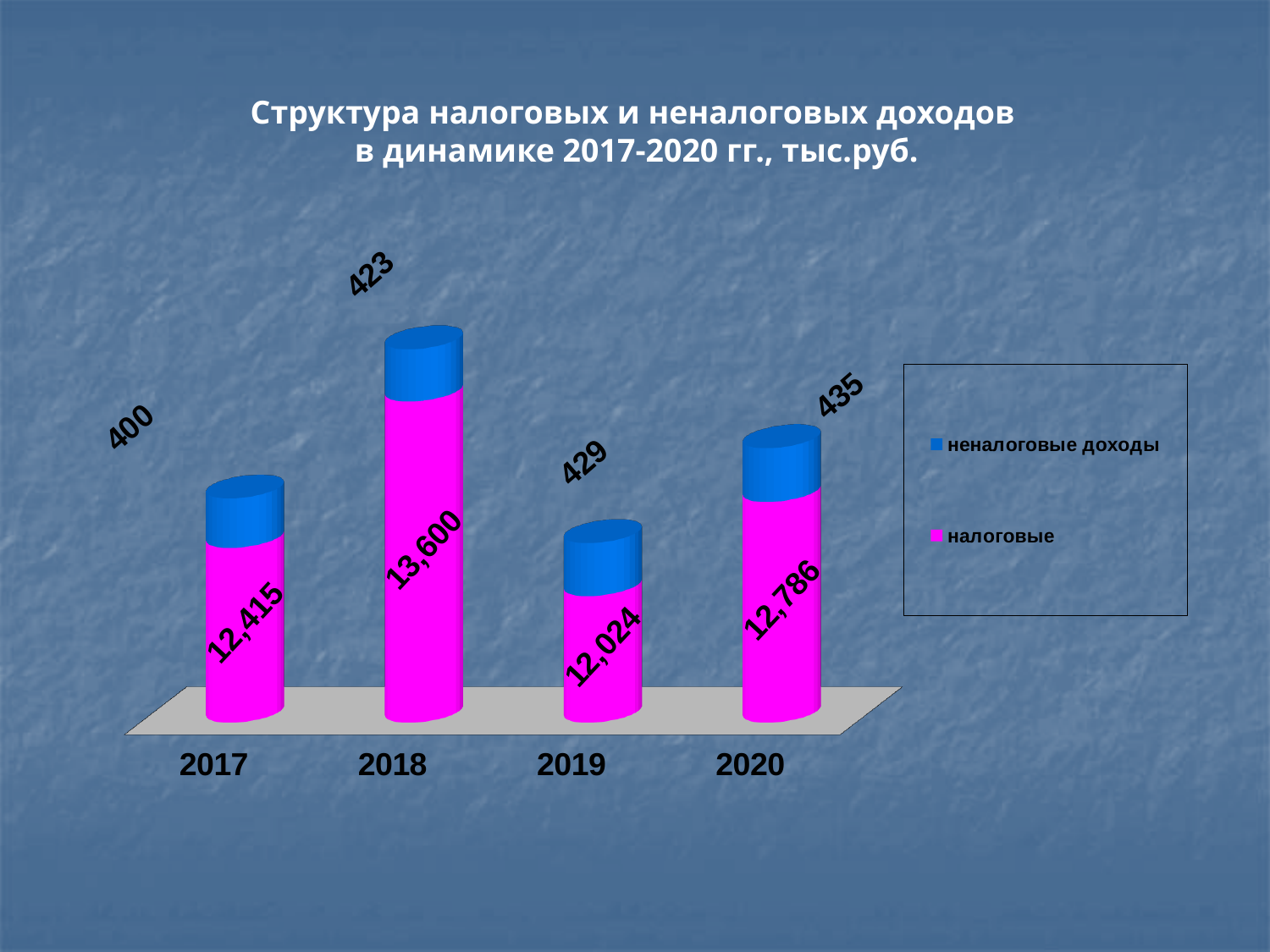
Which is larger, the налоговые value for 2017 or for 2020? 2020 What is the value of налоговые for 2019? 12,024 What is the value of неналоговые доходы for 2020? 435 How many series does the legend list? 2 How many years are shown on the x axis? 4 What kind of chart is shown on the slide? Stacked bar chart Which colour represents неналоговые доходы in the chart? Blue Which year has the lowest value for неналоговые доходы? 2017 What is the difference between the налоговые values for 2018 and 2019? 1,576 What is the total of the stacked bar for 2020? 13,221 What is the value of налоговые for 2018? 13,600 Which year has the highest value for налоговые? 2018